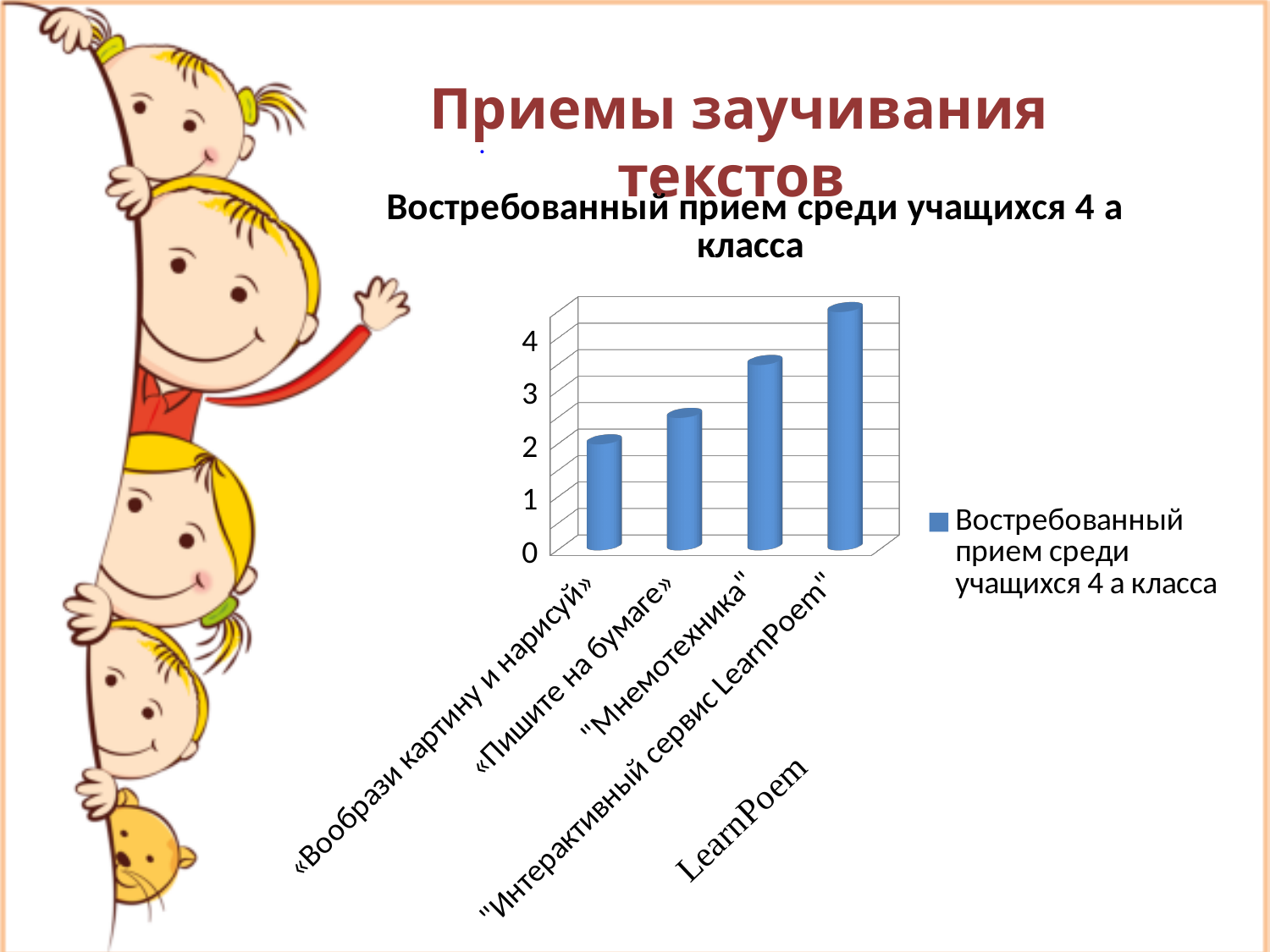
Is the value for "Мнемотехника" greater or less than 3? greater Which category has the lowest bar? «Вообрази картину и нарисуй» How many categories are plotted in the chart? 4 Is the value for «Пишите на бумаге» greater or less than 3? less What is the title of the chart? Востребованный прием среди учащихся 4 а класса What kind of chart is shown on the slide? bar chart Which is larger, the value for "Мнемотехника" or the value for «Пишите на бумаге»? "Мнемотехника" Do the bar values rise or fall from left to right along the x axis? rise Is the value for "Интерактивный сервис LearnPoem" greater or less than 4? greater How many series does the chart legend list? 1 Which category has the highest bar? "Интерактивный сервис LearnPoem"